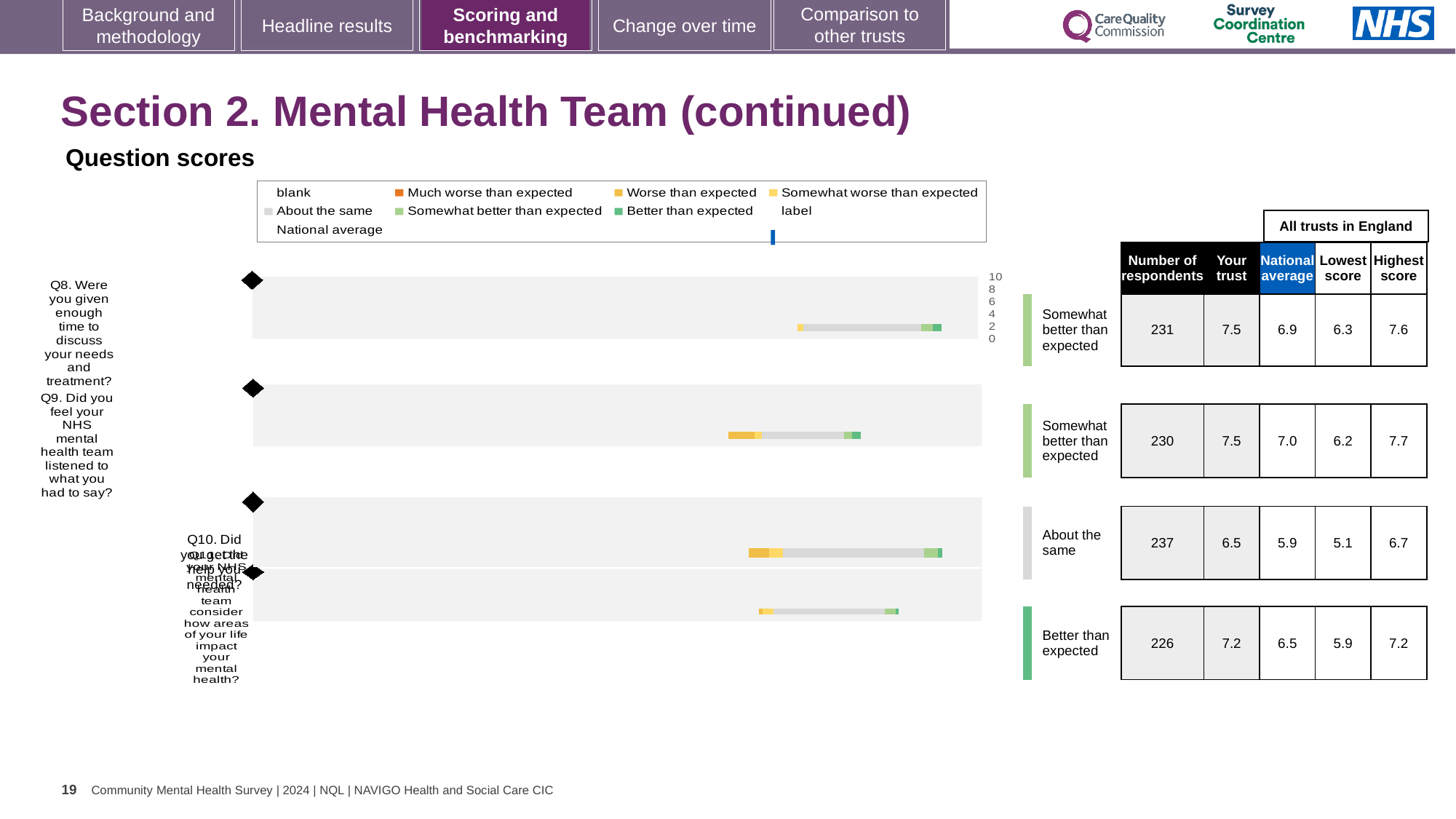
Which question has the lowest 'Your trust' score in the table beside the chart? Q10 Which question has the highest number of respondents in the table beside the chart? Q10 Which benchmark category is shown next to the Q10 bar? About the same What is the difference between the 'Your trust' score and the national average for Q11 in the table beside the chart? 0.7 In the table beside the chart, what is the number of respondents for Q8? 231 In the table beside the chart, what is the lowest score for Q9? 6.2 In the table beside the chart, what is the highest score for Q11? 7.2 How many question bars (Q8 to Q11) are plotted in the chart? 4 What kind of chart is shown under 'Question scores'? bar chart In the table beside the chart, what is the 'Your trust' score for Q9? 7.5 In the chart legend, what colour represents 'Much worse than expected'? orange In the table beside the chart, what is the national average for Q10? 5.9